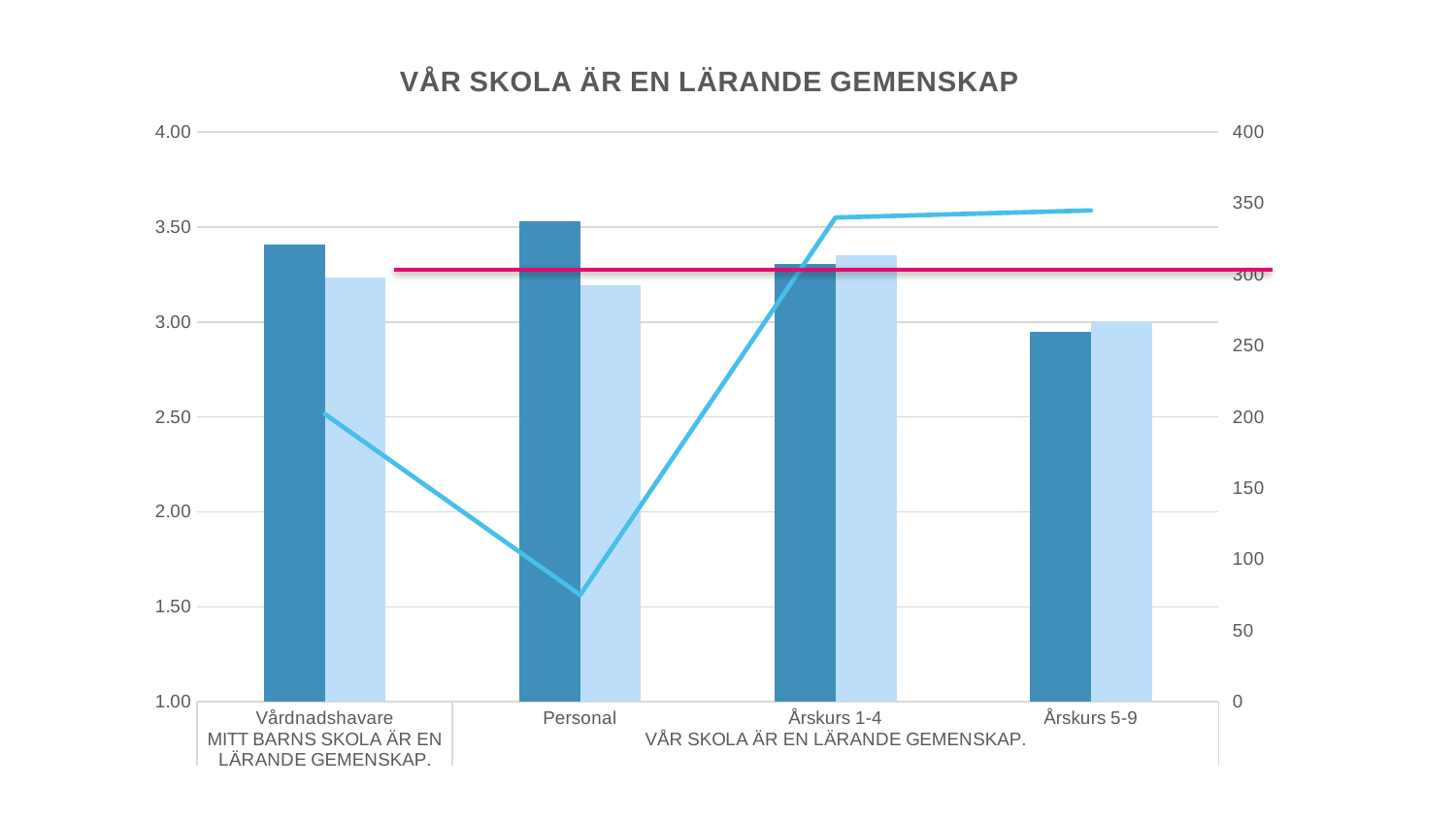
On the right-hand axis, is the line value for Personal greater or less than 100? less Which category has the shortest dark blue bar? Årskurs 5-9 Which category has the tallest light blue bar? Årskurs 1-4 Which category has the tallest dark blue bar? Personal Is the dark blue bar for Årskurs 5-9 greater or less than 3.50? less What kind of chart is shown on the slide? Combination bar and line chart How many categories are shown on the x axis? 4 On the right-hand axis, is the line value for Årskurs 1-4 greater or less than 300? greater Which dark blue bar is taller, Vårdnadshavare or Personal? Personal What is the title of the chart? VÅR SKOLA ÄR EN LÄRANDE GEMENSKAP Does the line rise or fall from Personal to Årskurs 1-4? rise